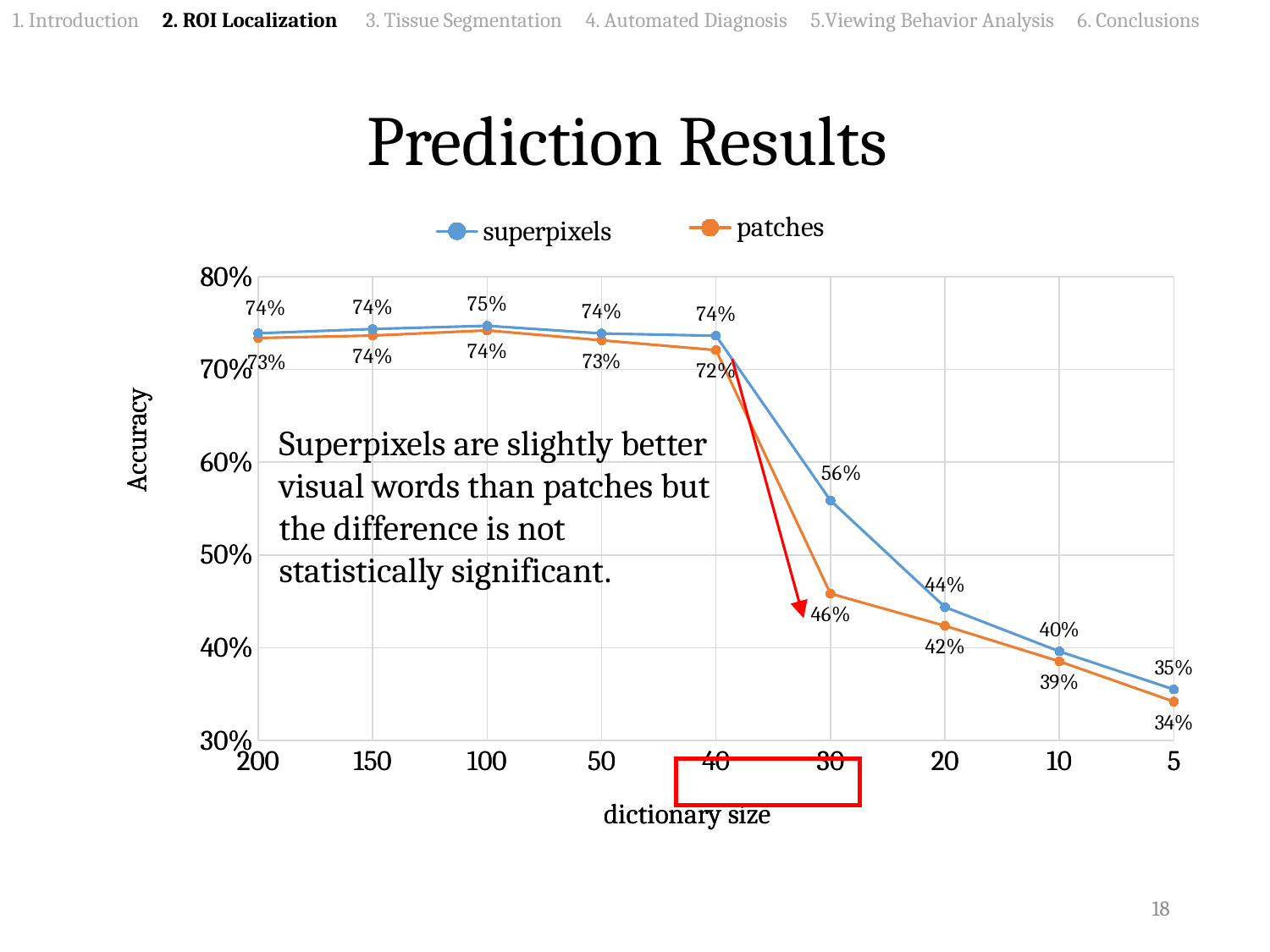
What is the difference between the superpixels and patches accuracy at dictionary size 30? 10% At which dictionary size does the superpixels series reach its highest accuracy? 100 What is the title of the chart? Prediction Results How many dictionary sizes are plotted on the x axis? 9 What is the accuracy for patches at dictionary size 5? 34% At which dictionary size is the patches accuracy lowest? 5 Which series has the higher accuracy at dictionary size 20, superpixels or patches? superpixels How many series does the legend list? 2 What is the accuracy for superpixels at dictionary size 30? 56% What type of chart is shown on the slide? line chart Does the superpixels accuracy rise or fall as the dictionary size decreases from 40 to 5? fall What is the accuracy for patches at dictionary size 40? 72%